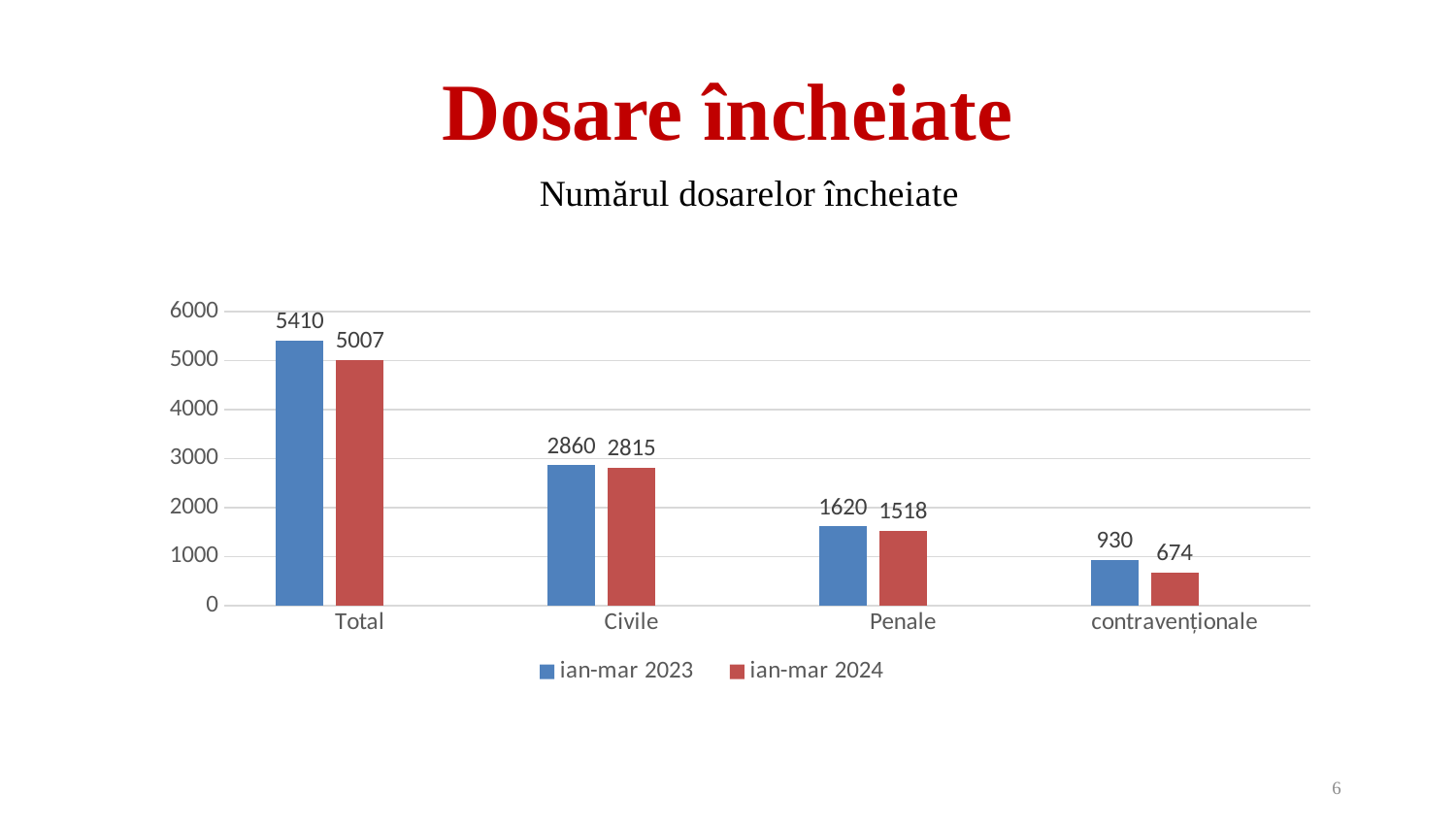
What is the difference between the ian-mar 2023 and ian-mar 2024 values for Total? 403 Which category has the highest value in the ian-mar 2023 series? Total How many categories are shown on the x axis? 4 What is the value for Penale in the ian-mar 2023 series? 1620 How many series does the legend list? 2 Which is larger for Penale: the ian-mar 2023 value or the ian-mar 2024 value? ian-mar 2023 What kind of chart is shown on the slide? bar chart What is the value for Civile in the ian-mar 2024 series? 2815 What is the difference between the ian-mar 2023 and ian-mar 2024 values for contravenționale? 256 What is the value for Total in the ian-mar 2023 series? 5410 What is the value for contravenționale in the ian-mar 2024 series? 674 Which category has the lowest value in the ian-mar 2024 series? contravenționale